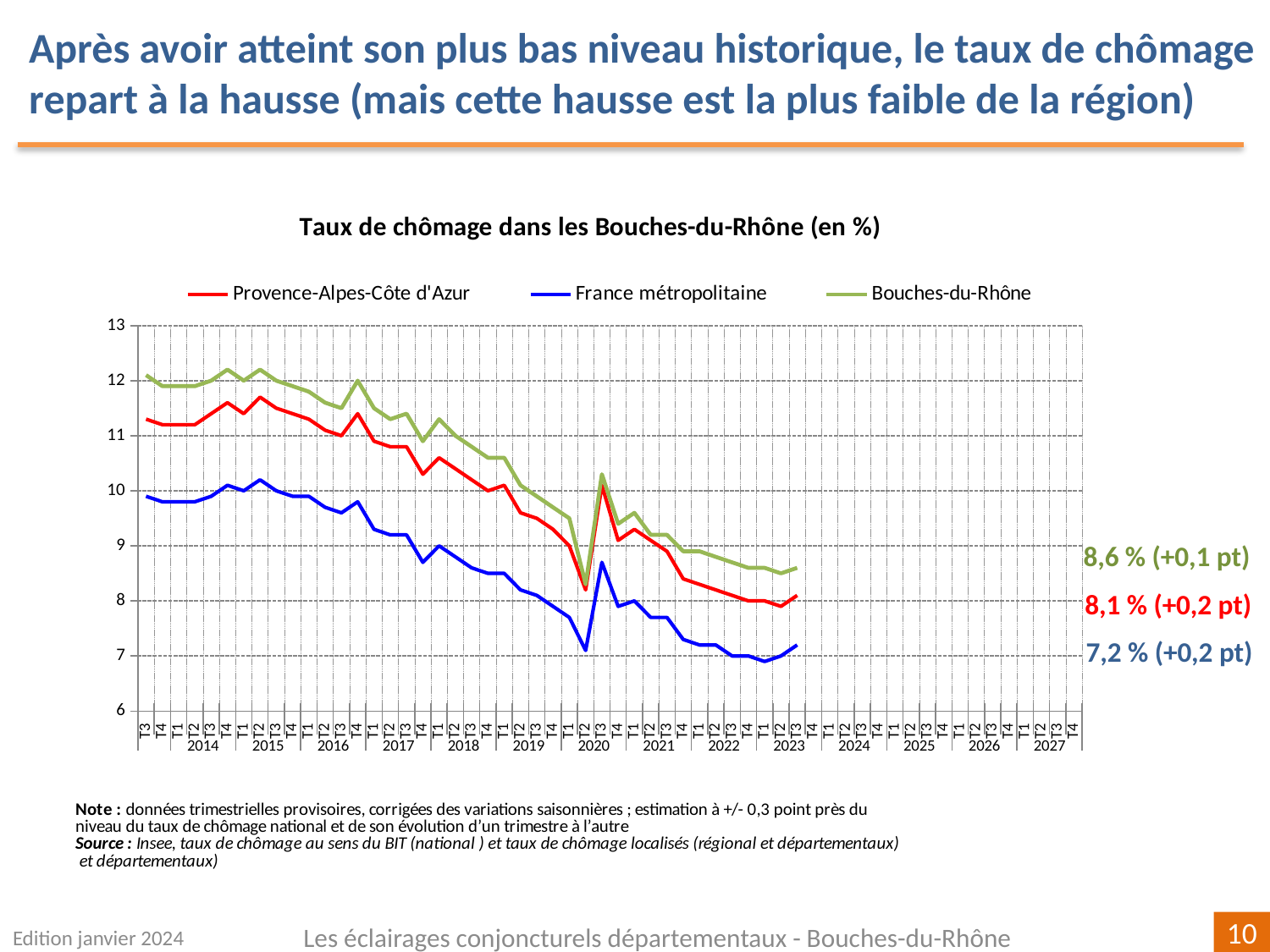
Is the value for France métropolitaine in T2 2020 greater or less than 8? less What kind of chart is shown on the slide? line chart Overall, do the unemployment rates rise or fall between 2014 and 2023? fall Which series has the lowest values across the whole period? France métropolitaine What is the difference between the latest Bouches-du-Rhône rate (8,6 %) and the latest France métropolitaine rate (7,2 %)? 1,4 points What is the latest unemployment rate shown for Bouches-du-Rhône? 8,6 % By how many points did the Bouches-du-Rhône rate change in the latest quarter, according to the annotation? +0,1 pt What is the title of the chart? Taux de chômage dans les Bouches-du-Rhône (en %) How many series does the legend list? 3 What is the latest unemployment rate shown for Provence-Alpes-Côte d'Azur? 8,1 % Which series has the highest values across the whole period? Bouches-du-Rhône What is the latest unemployment rate shown for France métropolitaine? 7,2 %